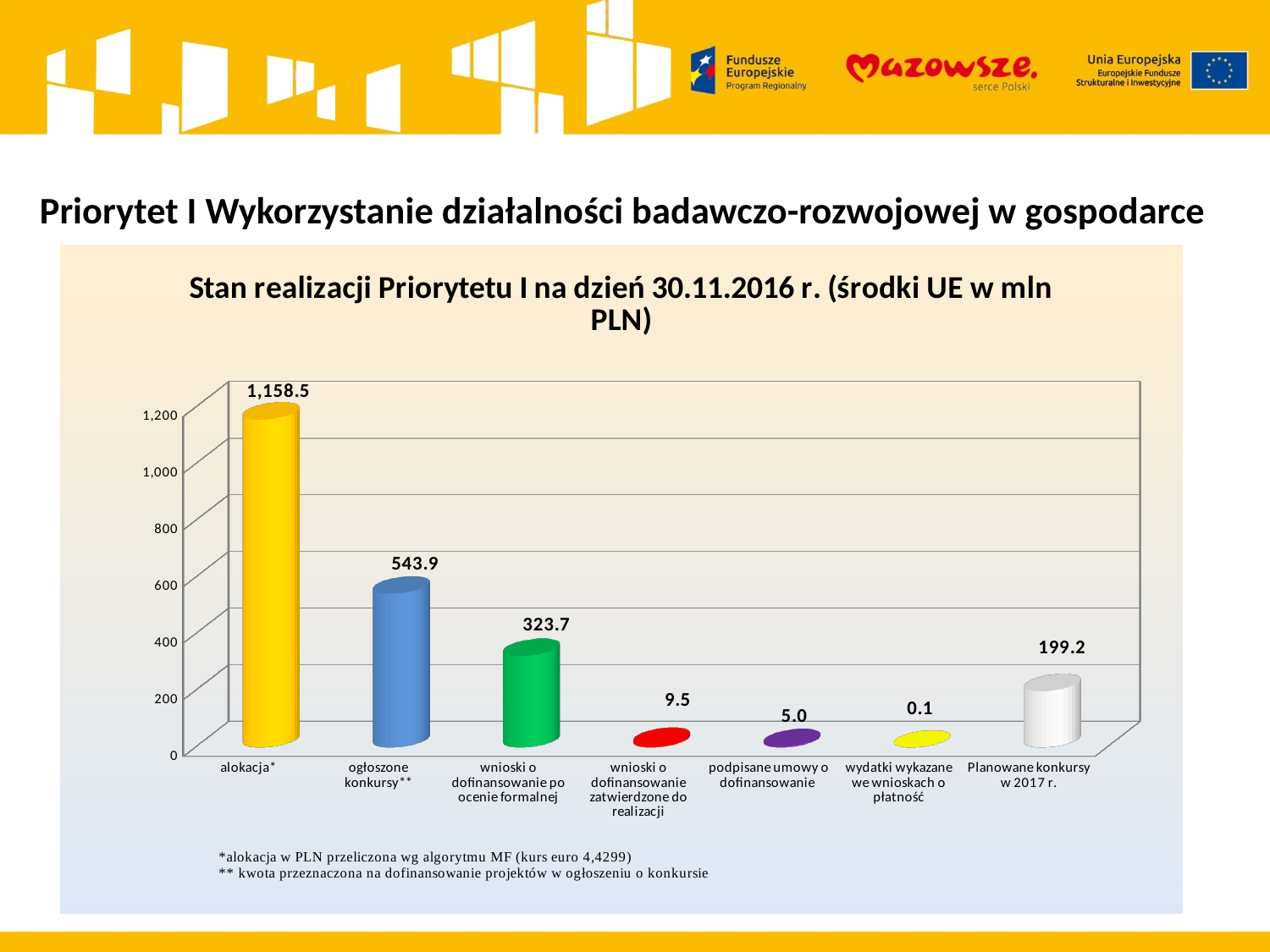
What is the value for "Planowane konkursy w 2017 r."? 199.2 What is the difference between the values for "ogłoszone konkursy**" and "wnioski o dofinansowanie po ocenie formalnej"? 220.2 What kind of chart is shown on the slide? bar chart What is the value for "podpisane umowy o dofinansowanie"? 5.0 What is the title of the chart? Stan realizacji Priorytetu I na dzień 30.11.2016 r. (środki UE w mln PLN) How many categories are shown on the chart? 7 Which category has the highest value? alokacja* What colour is the bar for "wnioski o dofinansowanie po ocenie formalnej"? green What is the value for "alokacja*"? 1,158.5 What is the value for "ogłoszone konkursy**"? 543.9 Which is larger: the value for "wnioski o dofinansowanie zatwierdzone do realizacji" or the value for "podpisane umowy o dofinansowanie"? wnioski o dofinansowanie zatwierdzone do realizacji Which category has the lowest value? wydatki wykazane we wnioskach o płatność